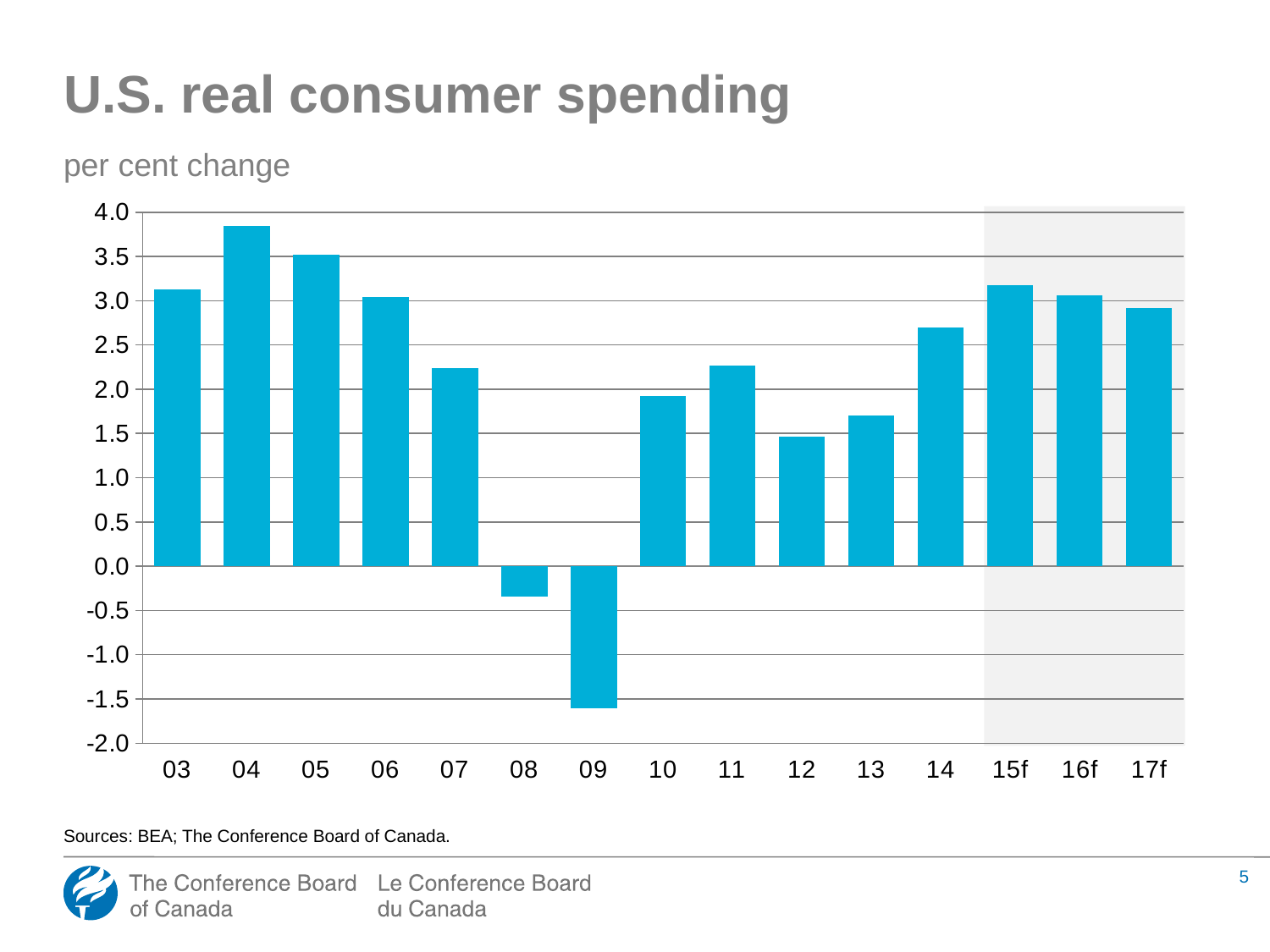
Do the values rise or fall from 15f to 17f? fall Which is larger, the value for 12 or the value for 14? 14 Is the value for 14 greater or less than 2.5? greater How many years are plotted on the x axis? 15 Which year has the lowest per cent change in U.S. real consumer spending? 09 Which year has the highest per cent change in U.S. real consumer spending? 04 Is the value for 04 greater or less than 3.5? greater Is the value for 08 greater or less than -0.5? greater What is the title of the chart? U.S. real consumer spending What kind of chart is shown on the slide? bar chart Which is larger, the value for 04 or the value for 05? 04